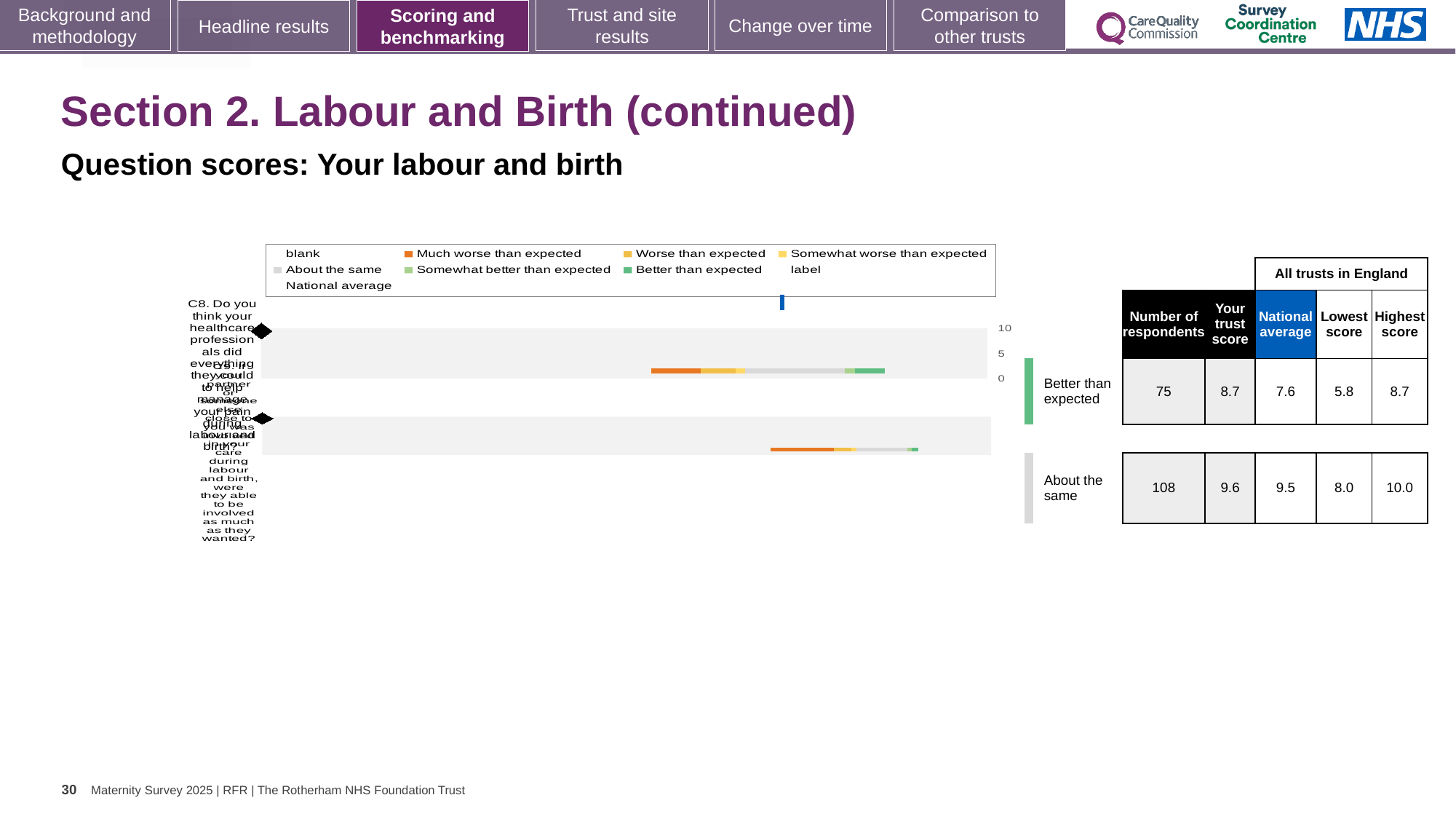
Which is larger for the question rated 'About the same': the trust score or the national average? trust score How many respondents answered the question rated 'Better than expected'? 75 How many questions (bars) are plotted in the chart? 2 What is the highest score across all trusts in England for the question rated 'About the same'? 10.0 By how much does the trust score exceed the national average for the question rated 'Better than expected'? 1.1 What is the national average for the question rated 'About the same'? 9.5 Which question had more respondents, the one rated 'Better than expected' or the one rated 'About the same'? About the same What kind of chart is shown on the slide? bar chart What is the trust score for the question rated 'Better than expected'? 8.7 What is the lowest score across all trusts in England for the question rated 'Better than expected'? 5.8 What colour does the legend use for 'Much worse than expected'? orange How many respondents answered the question rated 'About the same'? 108